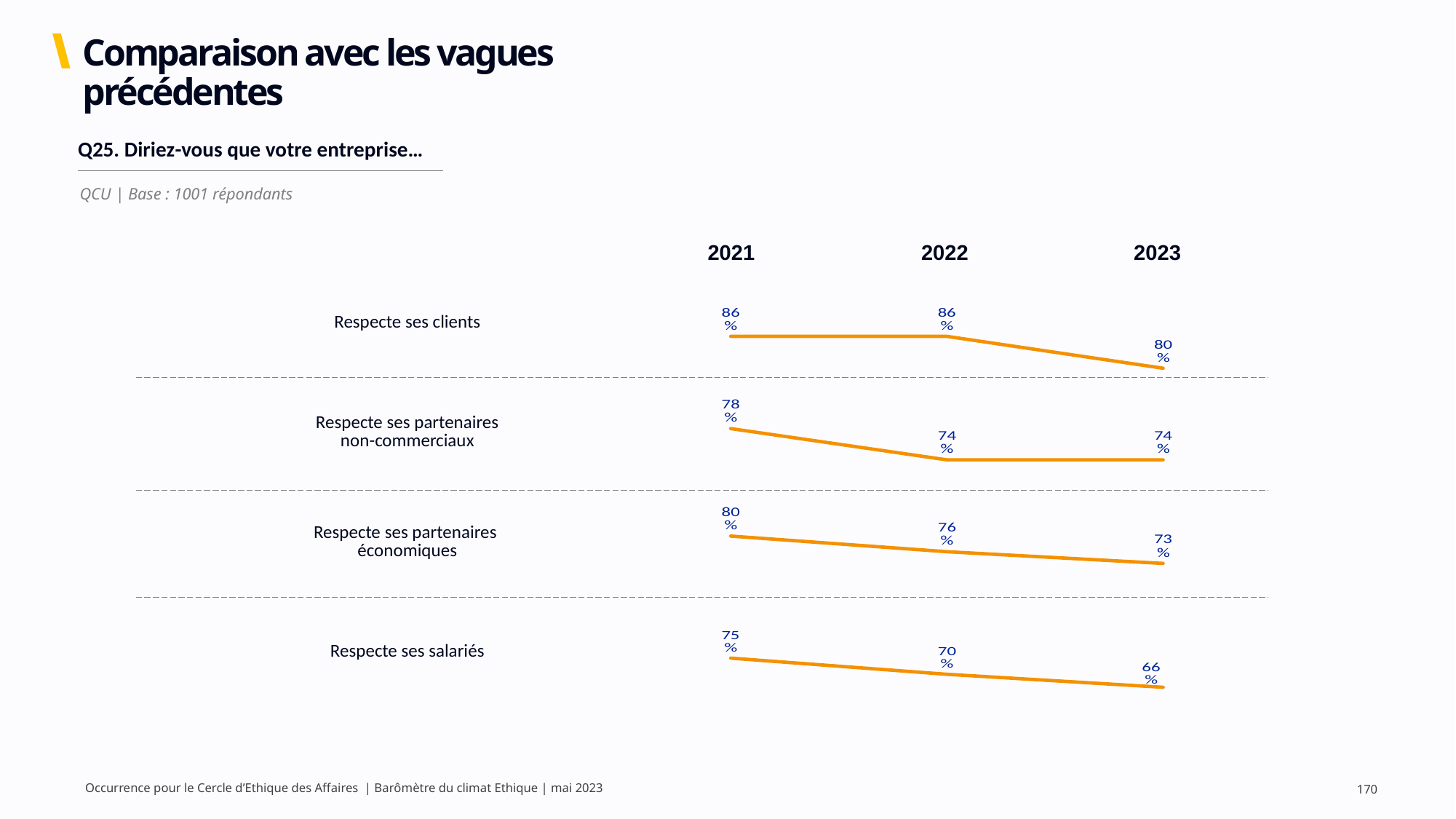
In the 'Respecte ses salariés' chart, what is the difference between the 2021 and 2023 values? 9 percentage points In the 'Respecte ses salariés' chart, do the values rise or fall from 2021 to 2023? fall In the 'Respecte ses salariés' chart, which year has the highest value? 2021 How many data points does the 'Respecte ses partenaires non-commerciaux' chart show? 3 In the 'Respecte ses clients' chart, which year has the lowest value? 2023 In the 'Respecte ses partenaires non-commerciaux' chart, what is the value for 2022? 74% In the 'Respecte ses partenaires économiques' chart, is the 2021 value larger or smaller than the 2022 value? larger In the 'Respecte ses salariés' chart, what is the value for 2021? 75% In the 'Respecte ses partenaires économiques' chart, what is the value for 2023? 73% What kind of chart is used for 'Respecte ses salariés'? line chart In the 'Respecte ses clients' chart, what is the difference between the 2022 and 2023 values? 6 percentage points In the 'Respecte ses clients' chart, what is the value for 2023? 80%